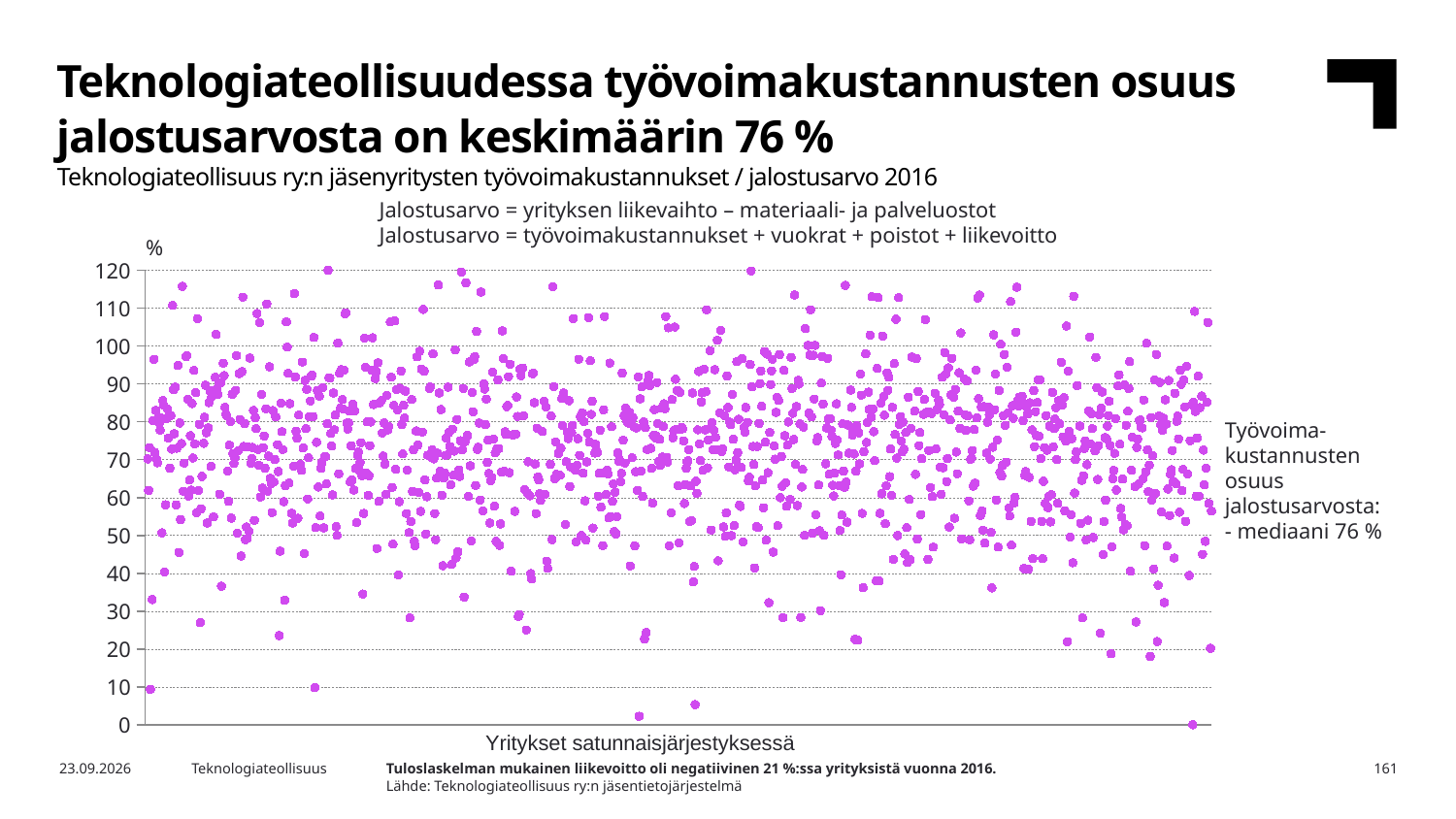
Which year's data does the chart subtitle say is plotted? 2016 What is the label of the x axis of the chart? Yritykset satunnaisjärjestyksessä What kind of chart is shown on the slide? scatter chart What unit is shown at the top of the y axis? % What is the highest value shown on the y axis of the chart? 120 Is the median share of labour costs in value added shown on the chart greater or less than 70? greater What is the interval between consecutive tick marks on the y axis? 10 According to the annotation on the right of the chart, what is the median share of labour costs in value added (mediaani)? 76 % Do most of the plotted points lie above or below the 100 gridline on the y axis? below